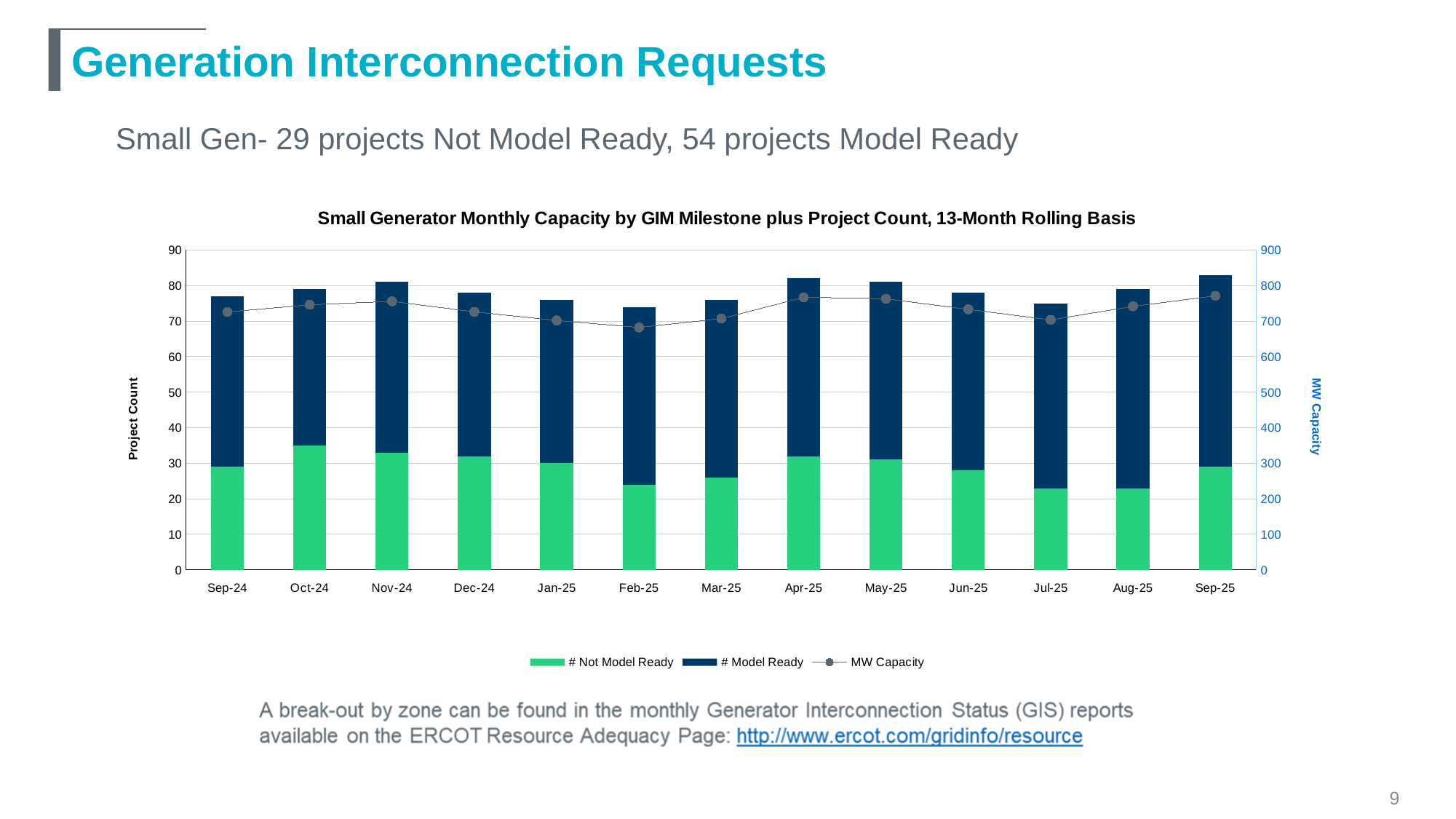
Is the MW Capacity value for Feb-25 greater or less than 700? less How many series does the chart legend list? 3 What type of chart is used for the project counts in the 'Small Generator Monthly Capacity by GIM Milestone plus Project Count' chart? Stacked bar chart (with a line for MW Capacity) According to the slide text, how many Small Gen projects are Not Model Ready? 29 Which month has the lowest MW Capacity value? Feb-25 According to the slide text, how many Small Gen projects are Model Ready? 54 Is the '# Not Model Ready' value for Feb-25 greater or less than 30? less How many months are shown on the x axis of the chart? 13 Is the total project count (stacked bar) for Apr-25 greater or less than 80? greater Which is larger, the '# Not Model Ready' value for Oct-24 or for Feb-25? Oct-24 Does the MW Capacity line rise or fall from Nov-24 to Feb-25? Fall